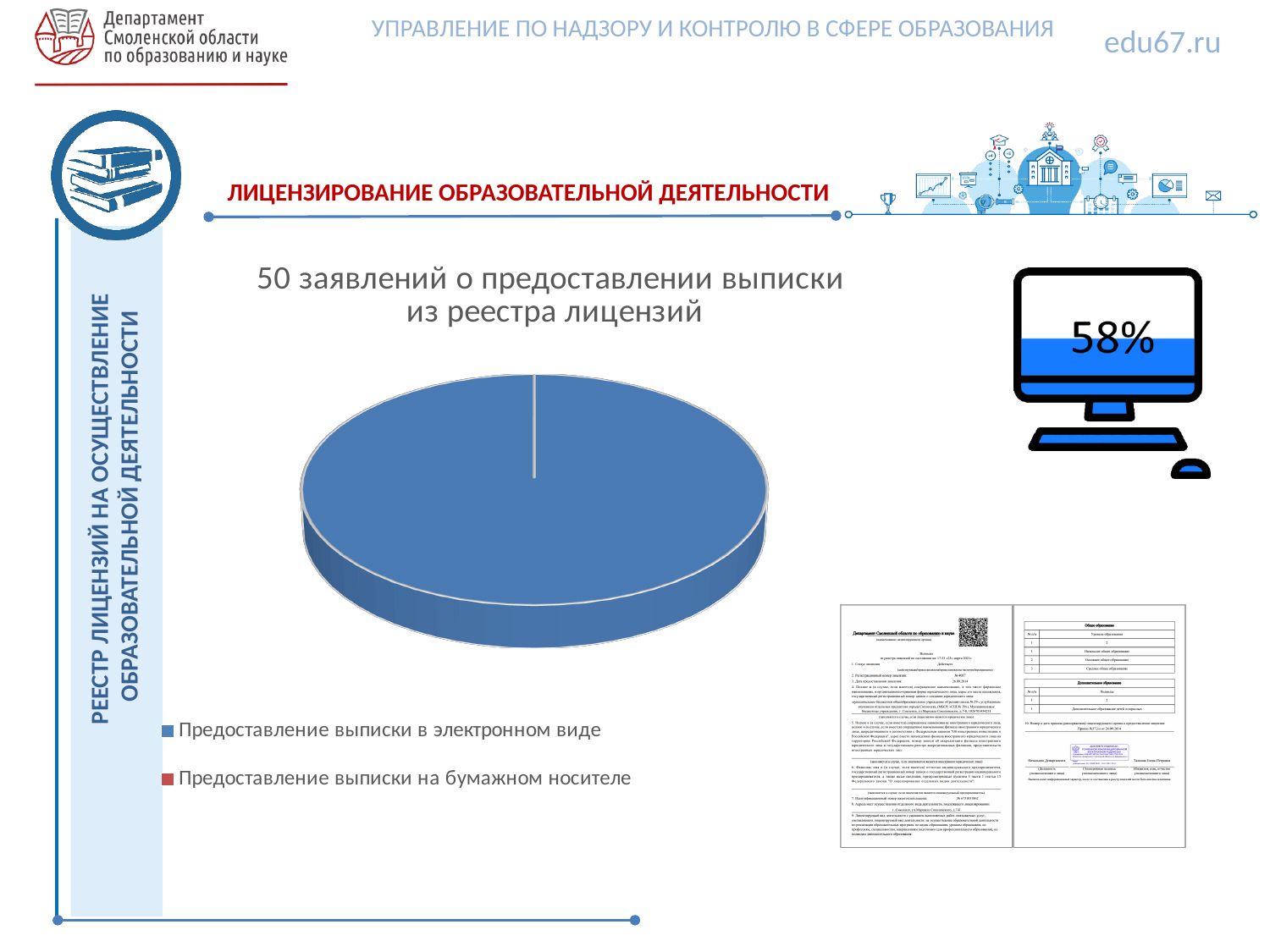
Which is larger in the pie chart: Предоставление выписки в электронном виде or Предоставление выписки на бумажном носителе? Предоставление выписки в электронном виде What kind of chart is shown on the slide? pie chart What colour represents Предоставление выписки в электронном виде in the pie chart legend? blue How many entries does the legend of the pie chart list? 2 How many applications does the pie chart title say were submitted for an extract from the register of licences? 50 Which category accounts for the smallest share of the pie chart? Предоставление выписки на бумажном носителе What is the title of the pie chart? 50 заявлений о предоставлении выписки из реестра лицензий Which category accounts for the largest share of the pie chart? Предоставление выписки в электронном виде